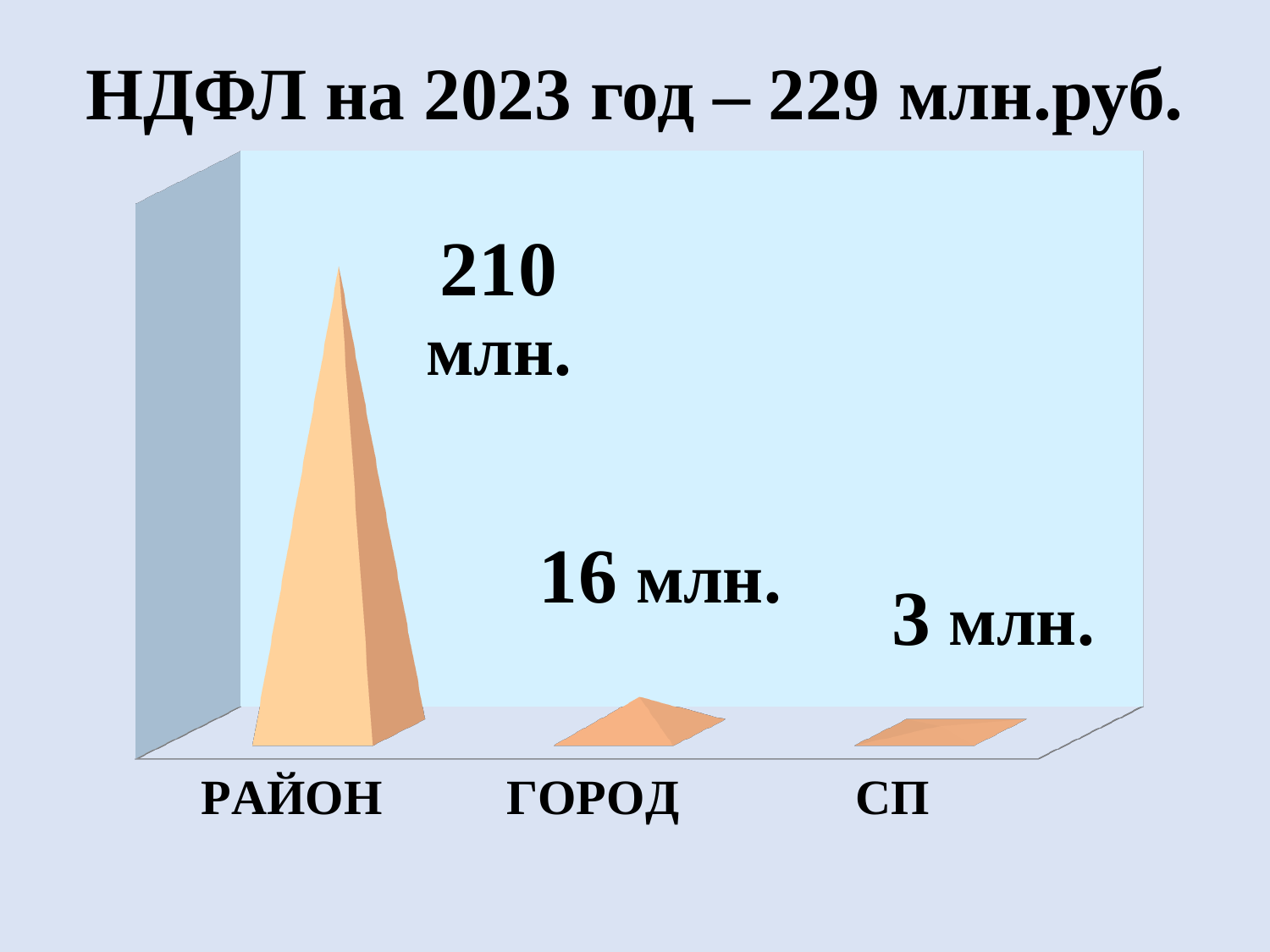
What is the difference between the values for РАЙОН and ГОРОД? 194 млн. What is the difference between the values for ГОРОД and СП? 13 млн. What is the title of the slide? НДФЛ на 2023 год – 229 млн.руб. Do the values rise or fall from left to right across the categories? fall What is the value shown for ГОРОД? 16 млн. What is the value shown for СП? 3 млн. How many categories are shown on the chart? 3 Which is larger, the value for ГОРОД or the value for СП? ГОРОД Which category has the highest value? РАЙОН What is the value shown for РАЙОН? 210 млн. What kind of chart is shown on the slide? bar chart Which category has the lowest value? СП